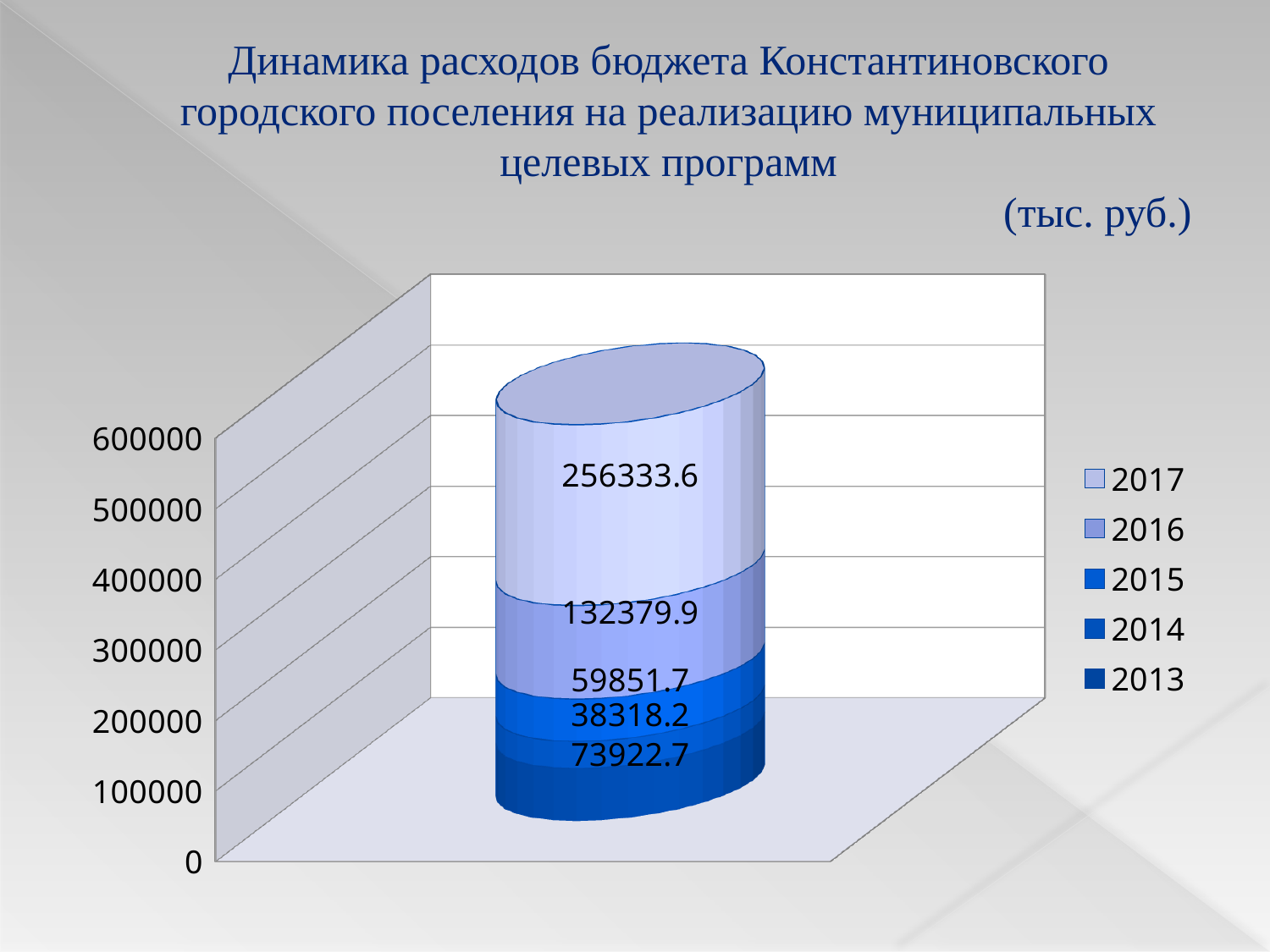
What is the value for 2015? 59851.7 What is the value for 2016? 132379.9 What kind of chart is shown on the slide? Stacked bar chart Which year has the highest value? 2017 What is the value for 2017? 256333.6 What is the difference between the values for 2017 and 2016? 123953.7 Which year has the lowest value? 2014 What is the value for 2013? 73922.7 What is the value for 2014? 38318.2 How many series does the legend list? 5 What is the total of the stacked bar? 560806.1 Which is larger, the value for 2013 or the value for 2015? 2013